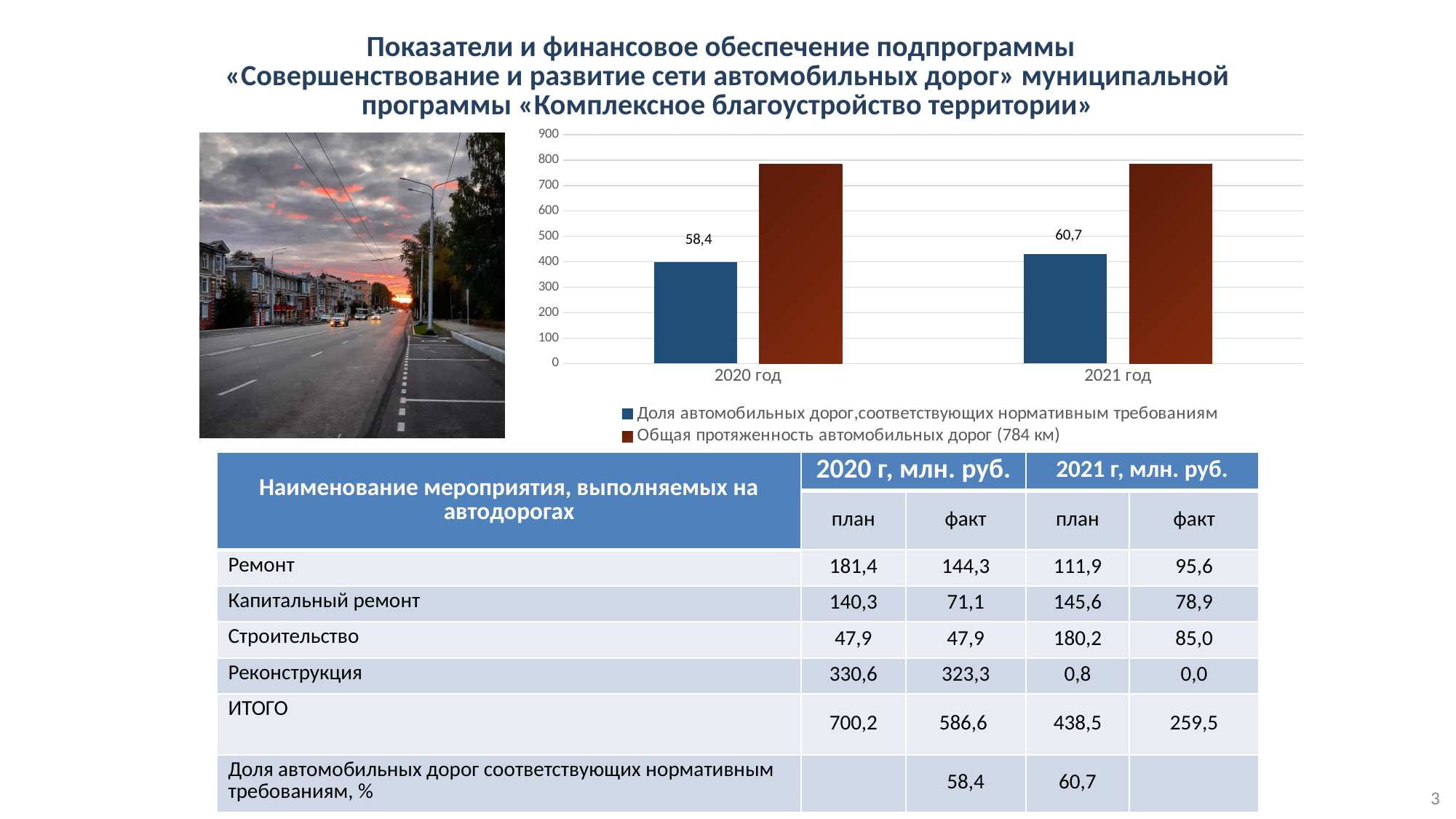
What is the data label on the blue bar for 2021 год? 60,7 Which year has the larger labelled value for the share of roads meeting regulatory requirements, 2020 год or 2021 год? 2021 год How many series does the chart legend list? 2 How many categories are shown on the x axis of the chart? 2 Does the labelled value of the blue series rise or fall from 2020 год to 2021 год? rise What is the data label on the blue bar for 2020 год? 58,4 Is the red bar for 2021 год greater or less than 900 on the axis? less What is the difference between the labelled values for 2021 год (60,7) and 2020 год (58,4)? 2,3 Is the red bar for 2020 год greater or less than 700 on the axis? greater Is the blue bar for 2021 год greater or less than 300 on the axis? greater What kind of chart is shown on the slide? bar chart What colour are the bars for the series 'Общая протяженность автомобильных дорог (784 км)'? dark red